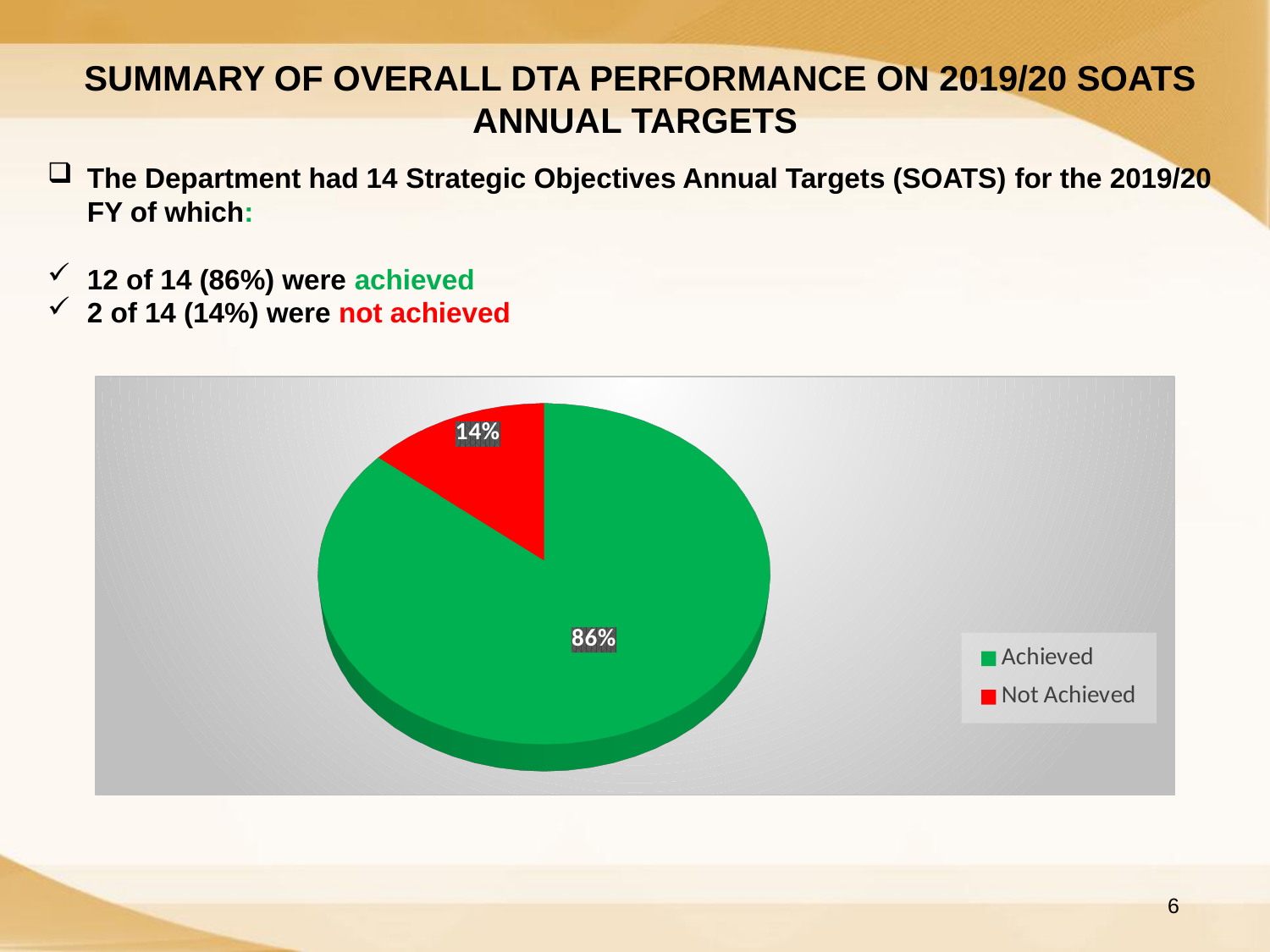
Which is larger, the Achieved slice or the Not Achieved slice? Achieved What is the difference in percentage points between the Achieved and Not Achieved slices? 72 What share of the pie is labelled Achieved? 86% What colour is the Not Achieved slice in the pie chart? red What kind of chart is shown on the slide? pie chart Which slice of the pie is the smallest? Not Achieved How many entries does the legend list? 2 How many slices does the pie chart have? 2 What colour is the Achieved slice in the pie chart? green What share of the pie is labelled Not Achieved? 14% Which slice of the pie is the largest? Achieved